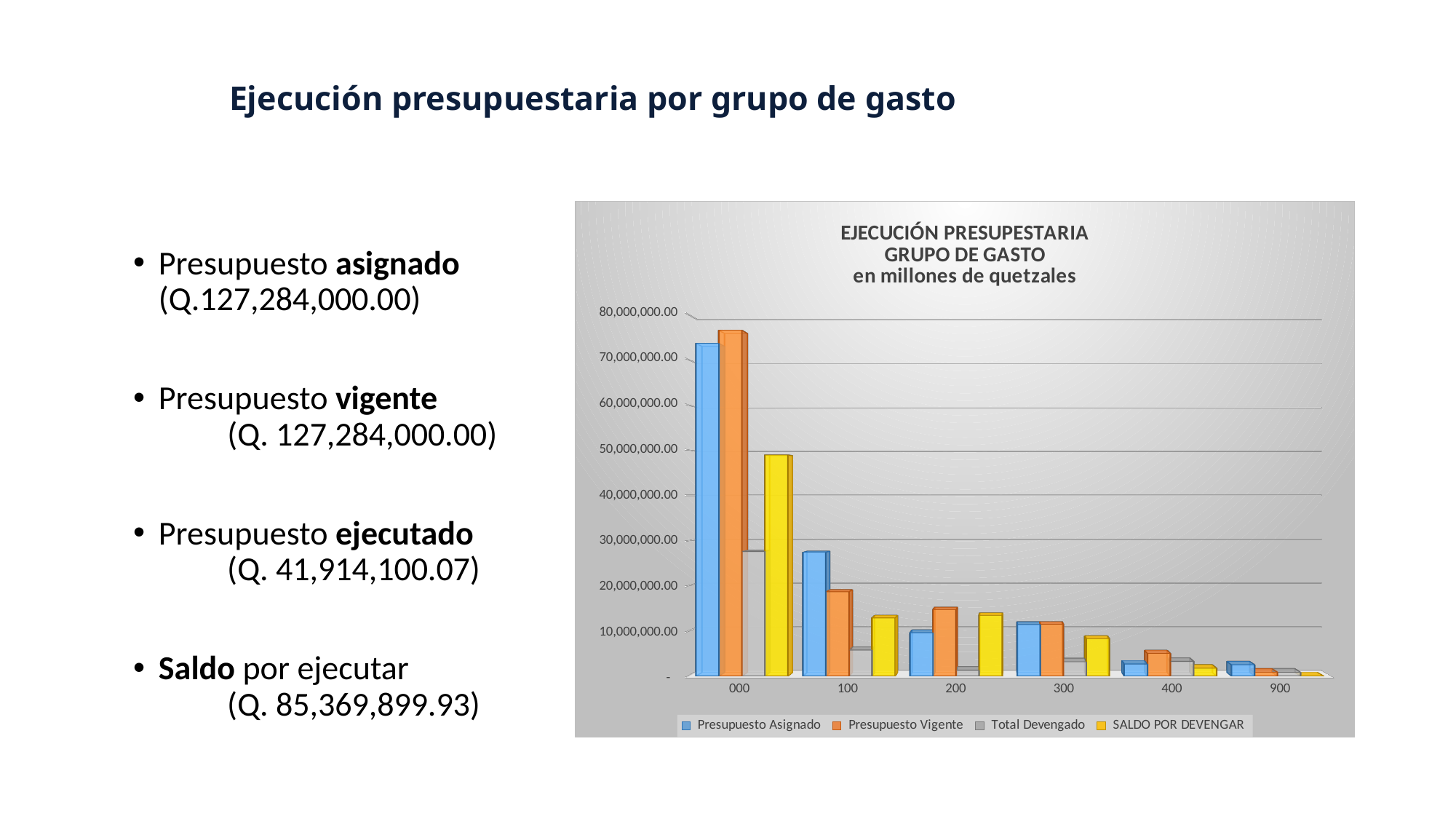
Which category has the highest Presupuesto Vigente value? 000 Which category has the lowest Presupuesto Vigente value? 900 Is the SALDO POR DEVENGAR value for category 000 greater or less than 40,000,000.00? greater For category 200, which is larger: Presupuesto Asignado or Presupuesto Vigente? Presupuesto Vigente Is the Presupuesto Vigente value for category 000 greater or less than 70,000,000.00? greater Do the Presupuesto Vigente values rise or fall from category 000 to category 900? fall Is the Presupuesto Asignado value for category 100 greater or less than 20,000,000.00? greater For category 100, which is larger: Presupuesto Asignado or Presupuesto Vigente? Presupuesto Asignado How many series does the chart legend list? 4 How many expense group categories are shown on the x axis of the chart? 6 What kind of chart is shown on the slide? Bar chart